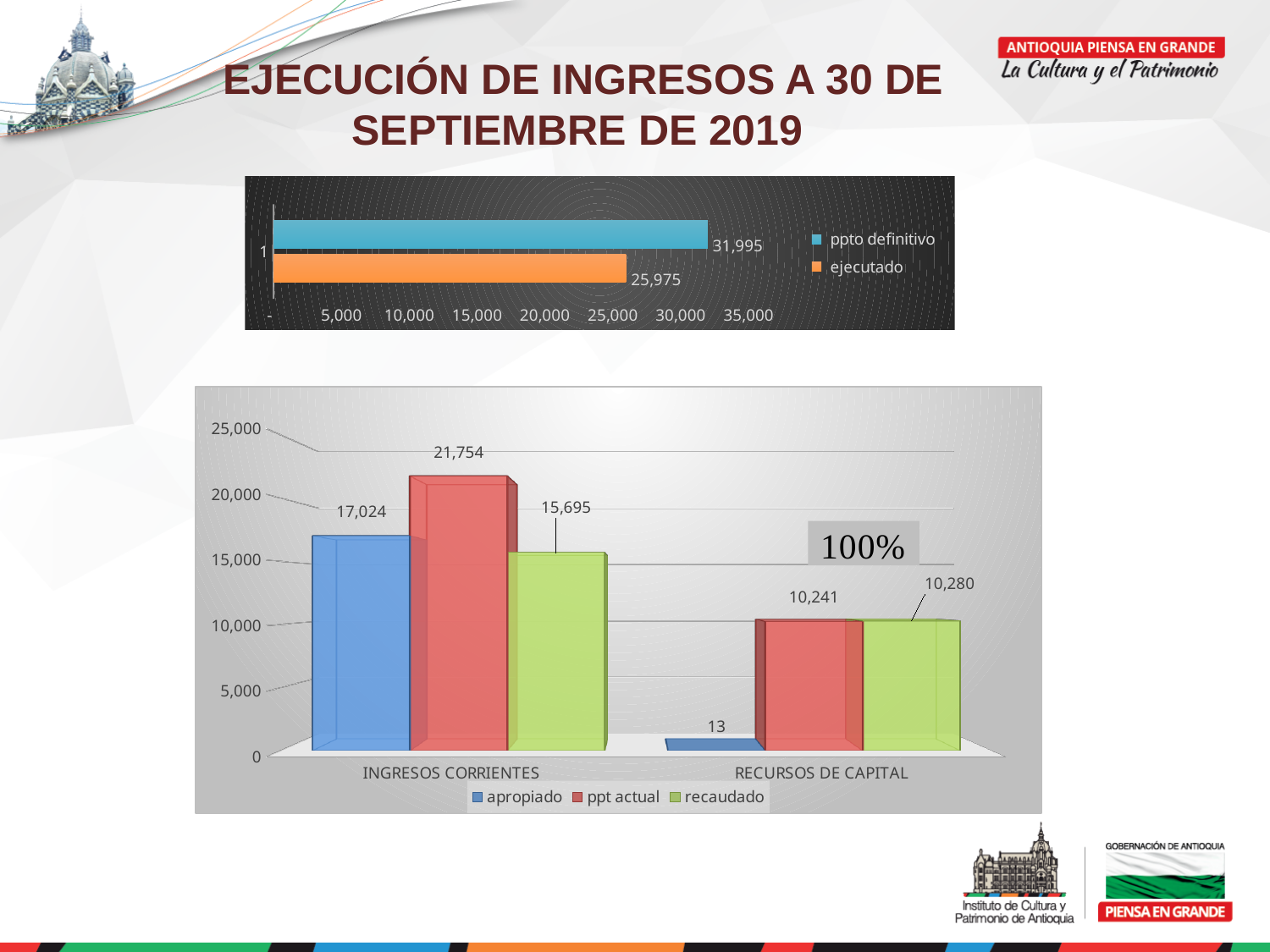
In the top chart, what is the value for ppto definitivo? 31,995 In the top chart, how many series does the legend list? 2 In the bottom chart, what is the apropiado value for RECURSOS DE CAPITAL? 13 In the bottom chart, what is the recaudado value for RECURSOS DE CAPITAL? 10,280 In the bottom chart, what is the difference between apropiado and recaudado for INGRESOS CORRIENTES? 1,329 In the top chart, what is the value for ejecutado? 25,975 In the bottom chart, how many categories are shown on the x axis? 2 In the bottom chart, what is the ppt actual value for INGRESOS CORRIENTES? 21,754 In the bottom chart, which series has the highest value for INGRESOS CORRIENTES? ppt actual In the top chart, what kind of chart is shown? Bar chart In the bottom chart, how many series does the legend list? 3 In the top chart, what is the difference between ppto definitivo and ejecutado? 6,020